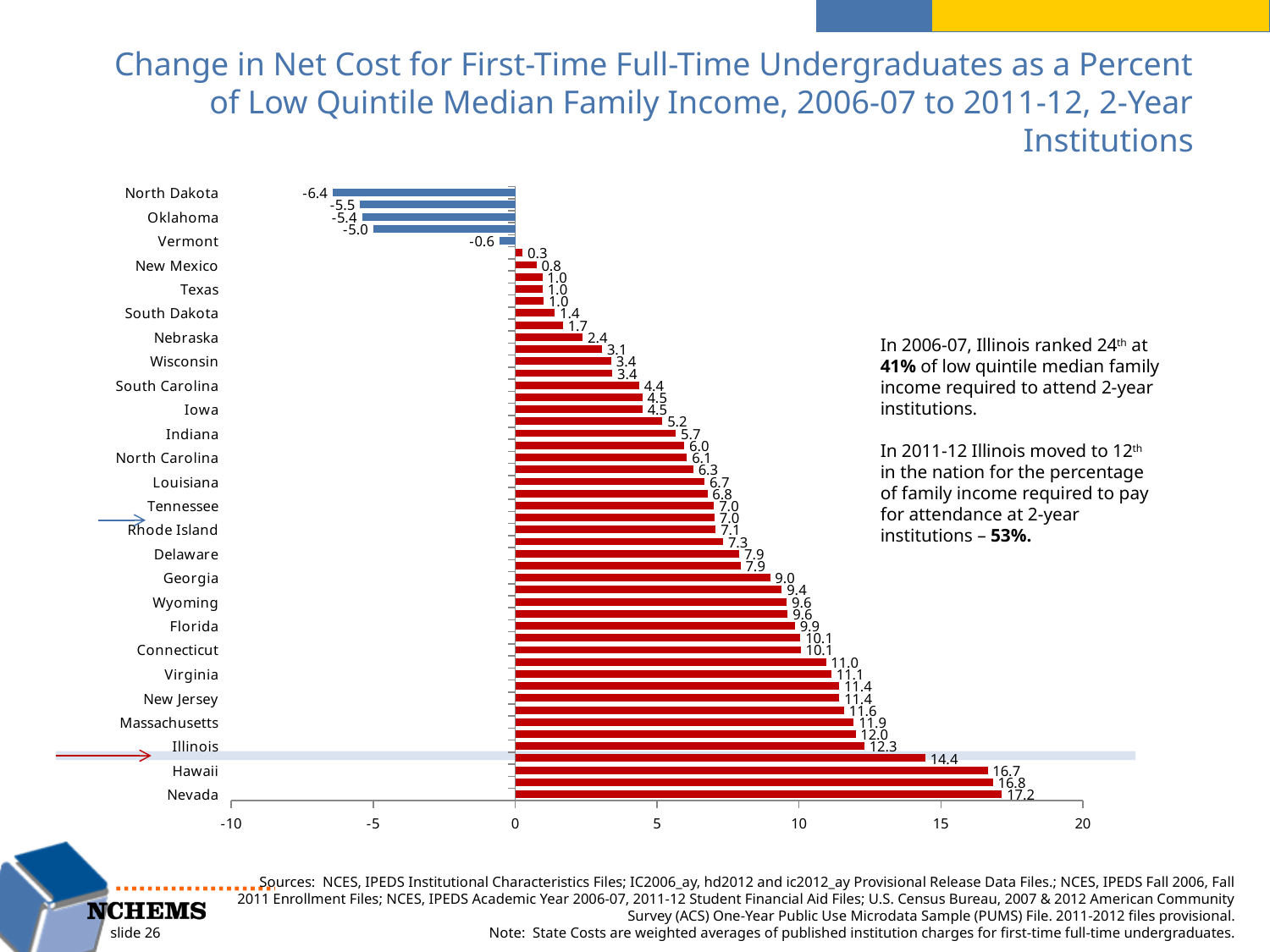
What type of chart is shown on the slide? Bar chart Is the value for Illinois greater or less than 10? greater Is the value for Texas greater or less than 5? less What is the difference between the values for Nevada and North Dakota? 23.6 What is the value for North Dakota? -6.4 What colour are the bars with negative values? Blue Is the value for Oklahoma greater or less than 0? less What is the value for Nevada? 17.2 Which has the larger value, Nevada or North Dakota? Nevada Which state has the lowest value in the chart? North Dakota Which state has the highest value in the chart? Nevada